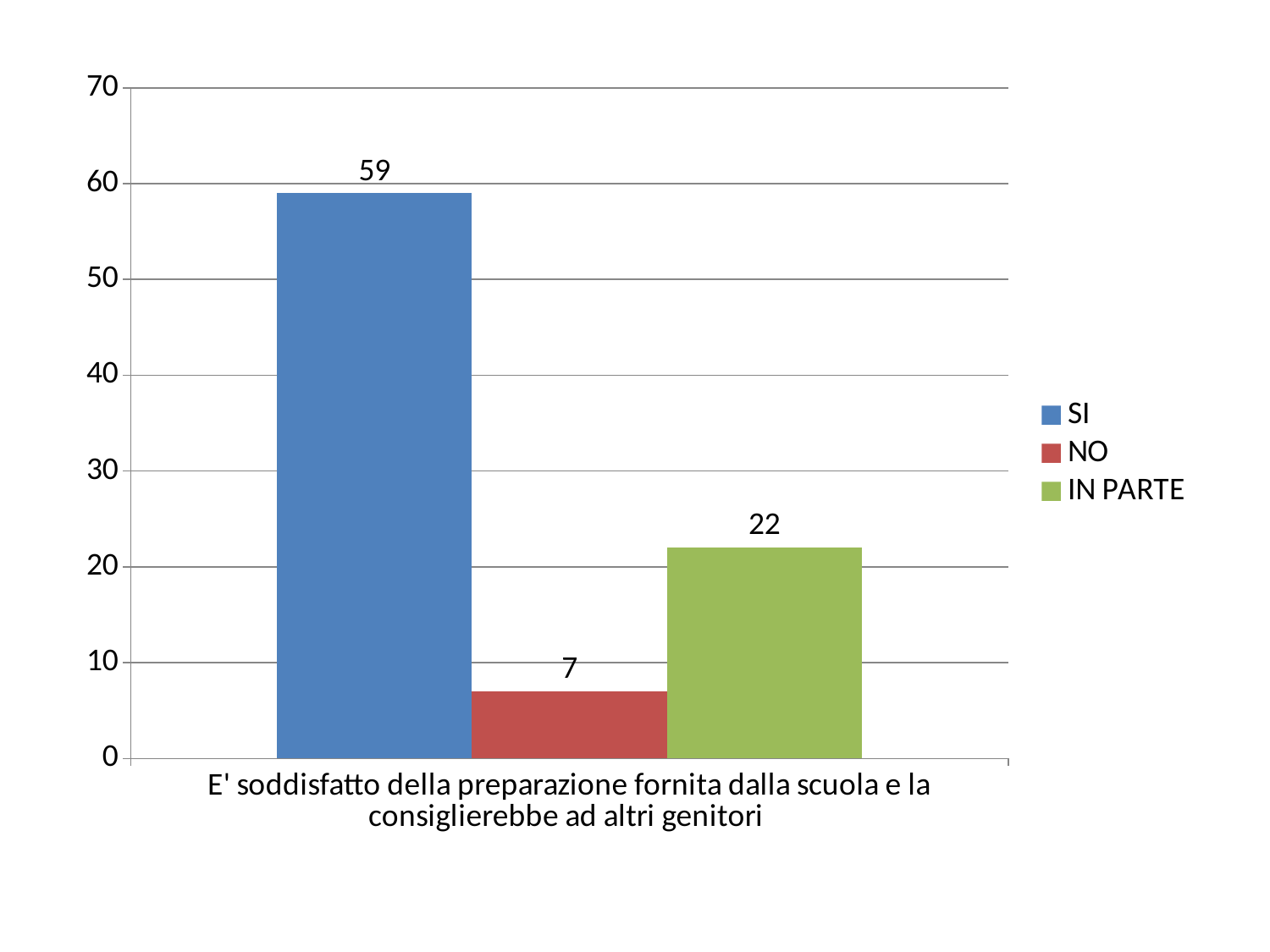
Which series has the lowest value? NO How many series does the legend list? 3 What colour is the bar for IN PARTE? green What is the value for IN PARTE? 22 What is the value for SI? 59 Which is larger, the value for NO or the value for IN PARTE? IN PARTE What is the difference between the values for SI and IN PARTE? 37 What is the value for NO? 7 What is the difference between the values for IN PARTE and NO? 15 What kind of chart is shown on the slide? bar chart Which series has the highest value? SI Is the value for SI greater or less than 50? greater